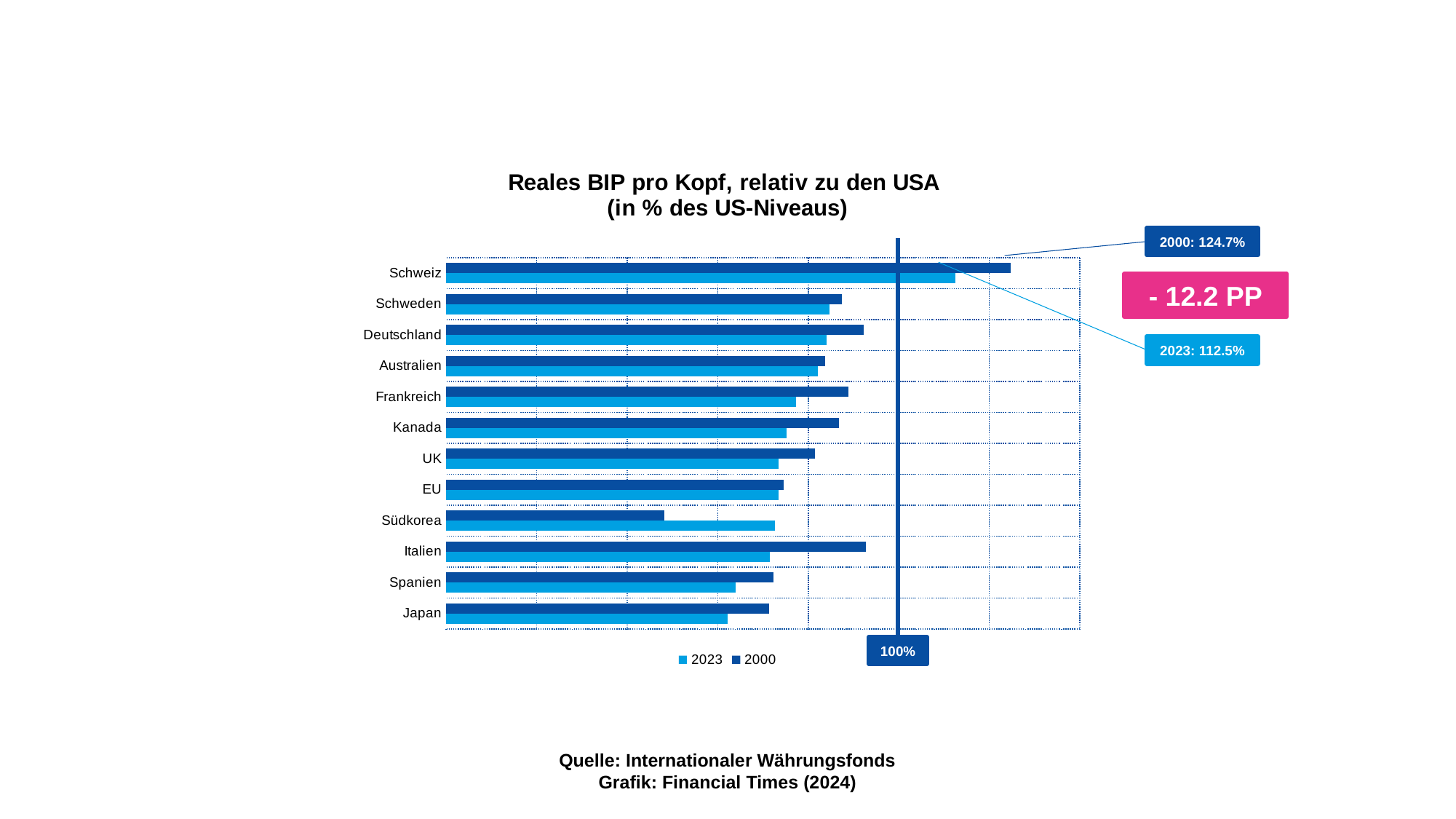
How many countries/regions are listed on the chart? 12 Which country has the lowest value in the 2000 series? Südkorea What was Schweiz's real GDP per capita relative to the USA in 2023? 112.5% By how many percentage points did Schweiz's value change from 2000 to 2023? - 12.2 PP Is the 2023 value for Japan greater or less than 100%? less Which country has the highest value in the 2000 series? Schweiz What was Schweiz's real GDP per capita relative to the USA in 2000? 124.7% Which series is shown in light blue according to the legend? 2023 What kind of chart is shown on the slide? bar chart For Südkorea, which is larger: the 2023 value or the 2000 value? 2023 Is the 2000 value for Italien greater or less than 100%? less How many series does the legend list? 2